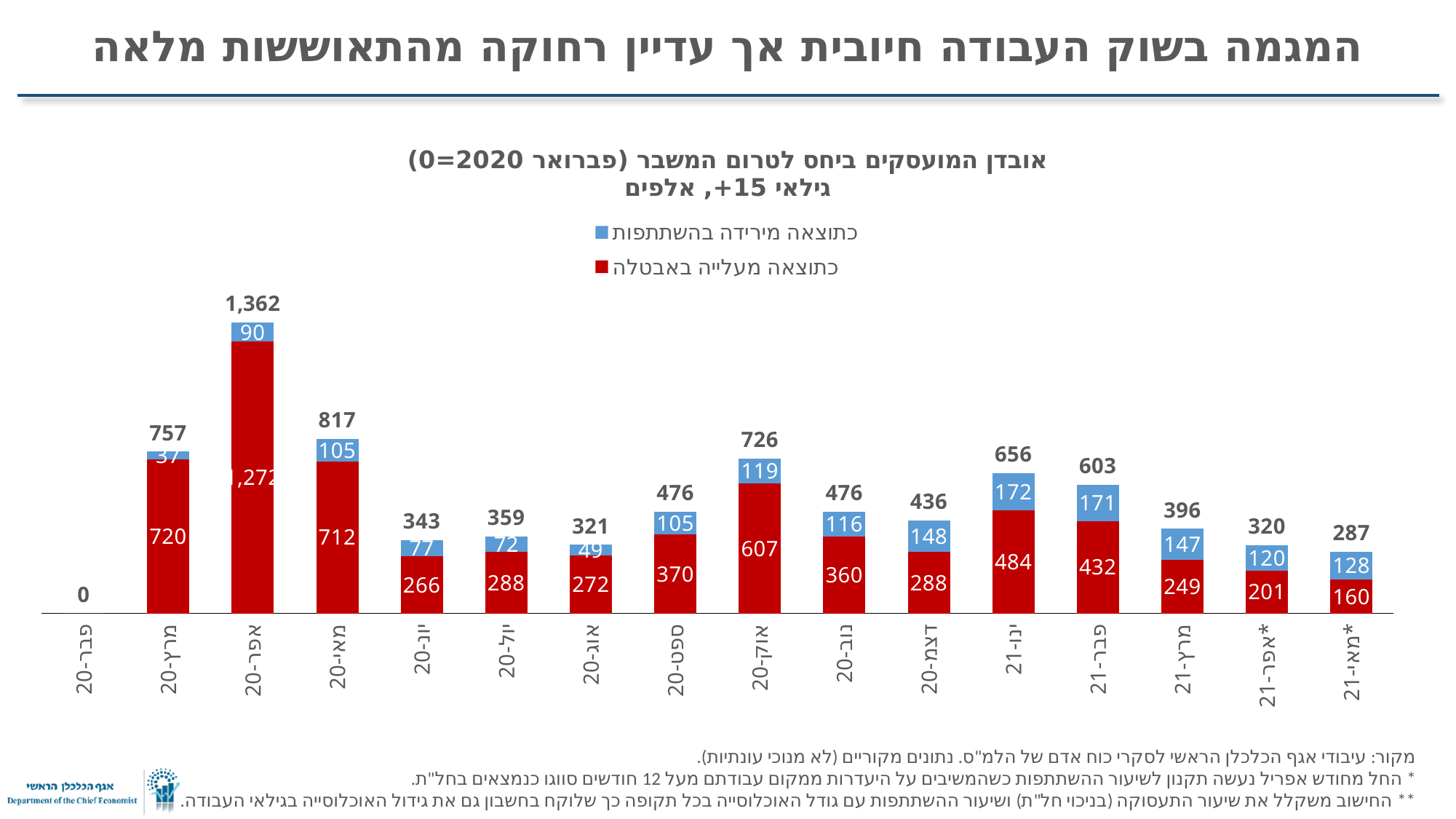
Do the total values rise or fall from ינו-21 to מאי-21*? fall What is the value of the red series (כתוצאה מעלייה באבטלה) for אוק-20? 607 Which colour represents the series כתוצאה מעלייה באבטלה? red Excluding פבר-20 (which is 0), which month has the lowest total value? מאי-21* How many months (categories) are shown on the x axis? 16 What is the value of the blue series (כתוצאה מירידה בהשתתפות) for ינו-21? 172 How many series does the legend list? 2 What is the difference between the total for מרץ-20 and the total for מאי-20? 60 Which is larger: the red series value for ספט-20 or the red series value for נוב-20? ספט-20 Which month has the highest total value? אפר-20 What type of chart is shown on the slide? stacked bar chart What is the total value of the stacked bar for אפר-20? 1,362